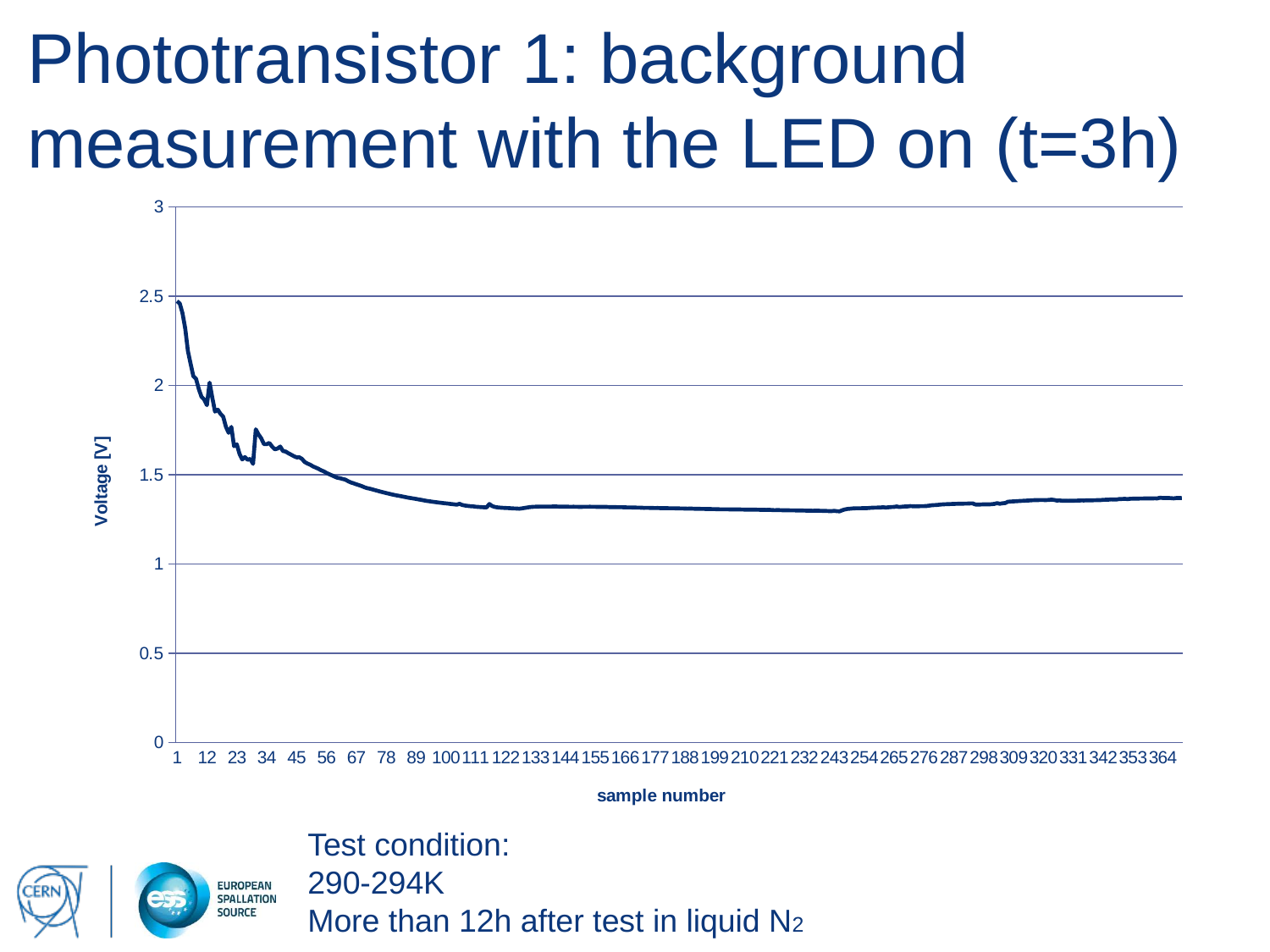
What is the highest value shown on the vertical axis? 3 What is the label of the horizontal axis? sample number What kind of chart is shown on the slide? line chart Is the voltage at sample number 1 greater or less than 2? greater Which has the higher voltage, sample number 1 or sample number 364? sample number 1 Which has the higher voltage, sample number 23 or sample number 100? sample number 23 Does the voltage rise or fall over the first 100 samples? fall What is the label of the vertical axis? Voltage [V] Is the voltage at sample number 12 greater or less than 2.5? less Is the voltage at sample number 199 greater or less than 1.5? less